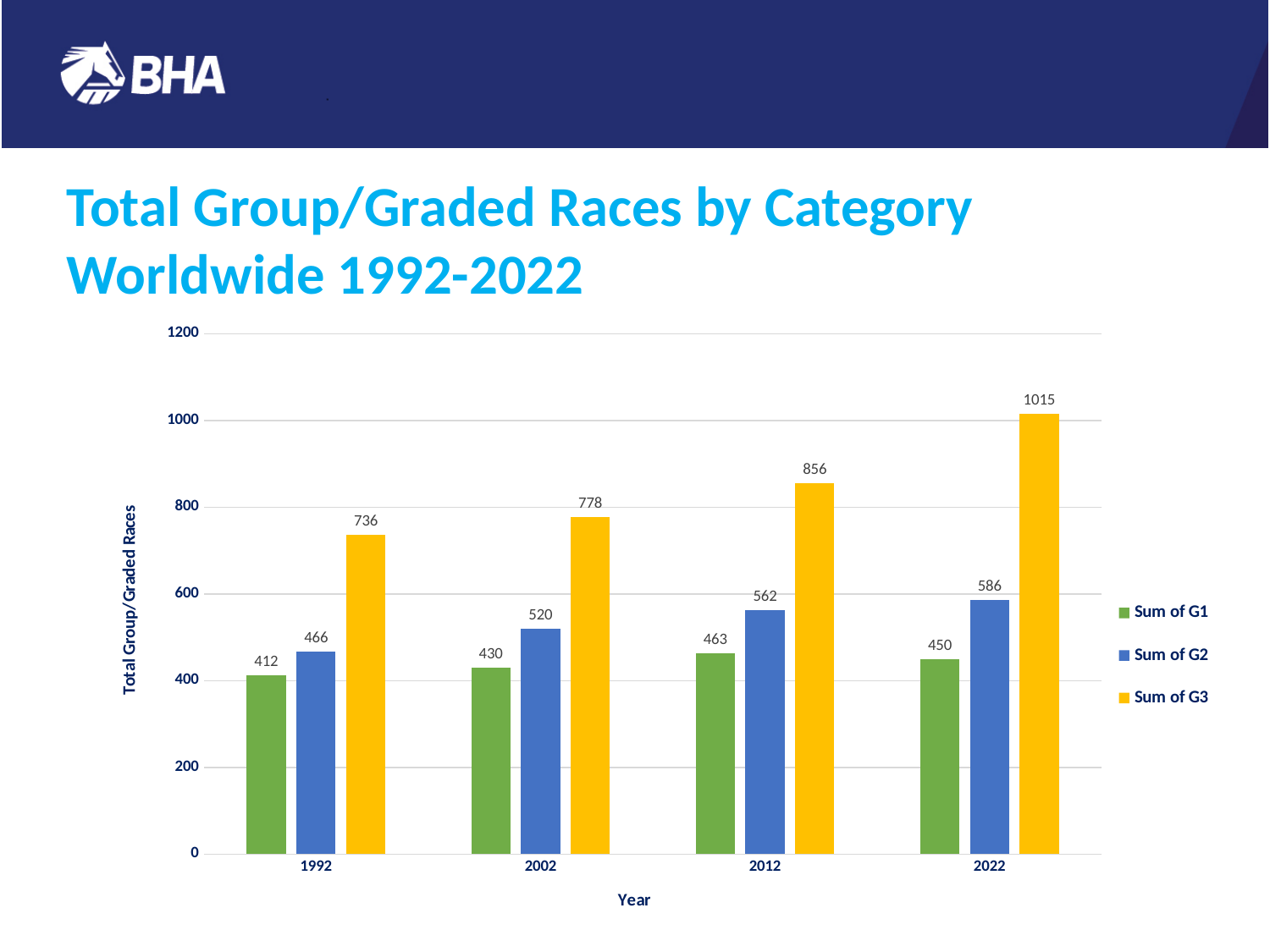
What is the value of Sum of G1 for 1992? 412 Which year has the highest Sum of G3 value? 2022 How many years are shown on the x axis? 4 Which is larger: Sum of G1 in 2012 or Sum of G1 in 2022? Sum of G1 in 2012 Which year has the lowest Sum of G1 value? 1992 What is the value of Sum of G2 for 2012? 562 What kind of chart is shown on the slide? bar chart Does the Sum of G3 series rise or fall from 1992 to 2022? rise What is the difference between Sum of G3 in 2022 and Sum of G3 in 1992? 279 What is the value of Sum of G3 for 2022? 1015 Is the value of Sum of G2 for 2002 greater or less than 600? less How many series does the legend list? 3